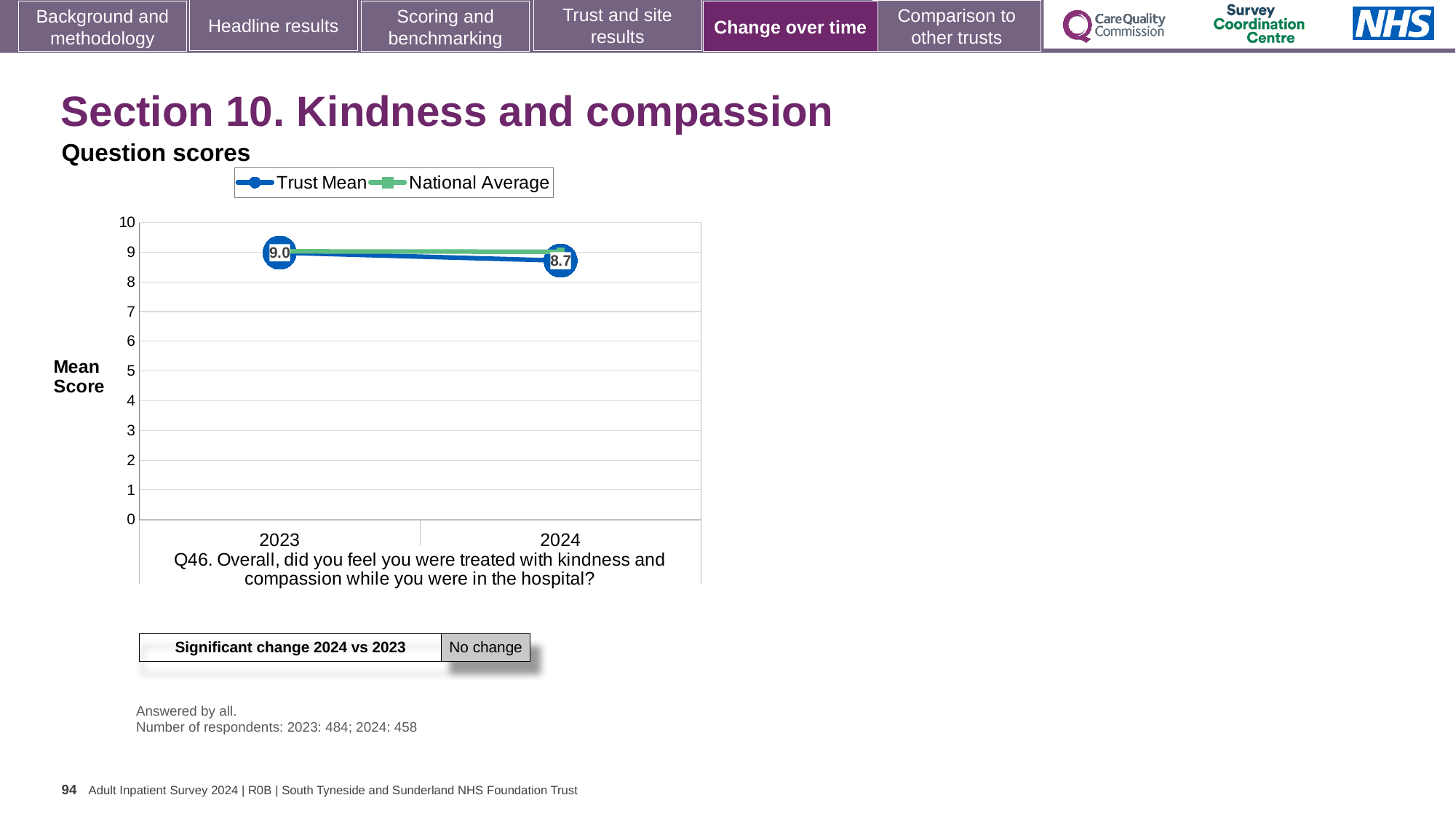
What is the Trust Mean score for 2024? 8.7 How many years are shown on the x axis? 2 How many series does the legend list? 2 What is the Trust Mean score for 2023? 9.0 By how much did the Trust Mean score change from 2023 to 2024? 0.3 Is the National Average value for 2024 greater or less than 8? greater Which year has the higher Trust Mean score, 2023 or 2024? 2023 What is the label on the y axis of the chart? Mean Score Is the National Average value for 2023 greater or less than 7? greater Does the Trust Mean score rise or fall from 2023 to 2024? fall In which year is the Trust Mean score lowest? 2024 What kind of chart is shown on the slide? line chart